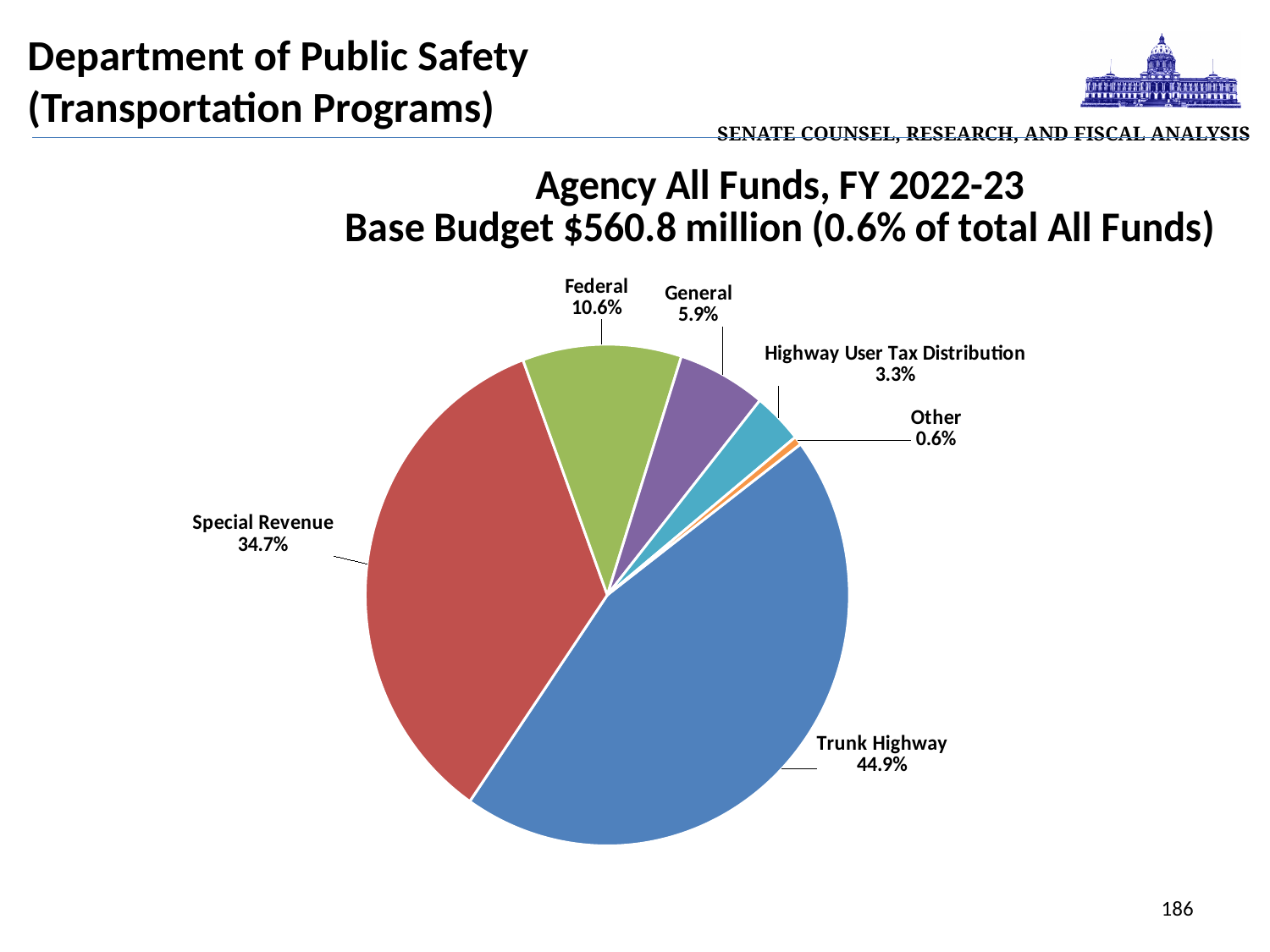
What is the value shown for Special Revenue? 34.7% Which category has the largest slice of the pie? Trunk Highway What kind of chart is shown on the slide? Pie chart How many slices does the pie chart have? 6 What is the title of the chart? Agency All Funds, FY 2022-23 Base Budget $560.8 million (0.6% of total All Funds) What is the difference between the Trunk Highway and Special Revenue shares? 10.2% Which is larger, the General slice or the Federal slice? Federal What is the difference between the Federal and General shares? 4.7% What share of the pie does Trunk Highway represent? 44.9% Which category has the smallest slice of the pie? Other What is the value shown for Highway User Tax Distribution? 3.3% What is the value shown for Federal? 10.6%